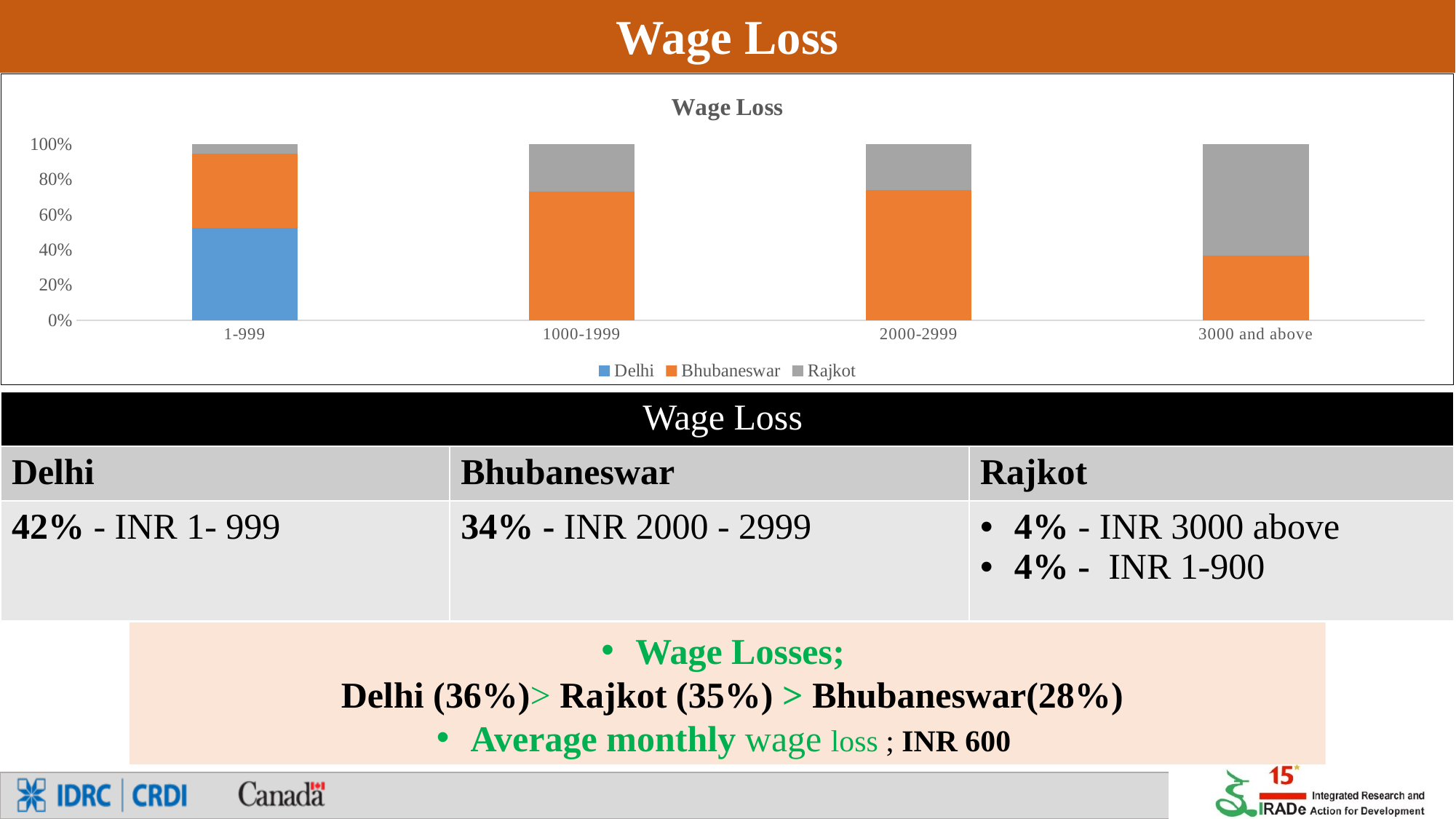
Which colour represents Rajkot in the chart? Grey Is the Bhubaneswar share in the 1000-1999 bar greater or less than 60%? greater In which category does Delhi appear in the stacked bars? 1-999 In which category is the Rajkot share the largest? 3000 and above Is the Rajkot share in the 3000 and above bar greater or less than 50%? greater What is the title of the chart? Wage Loss What kind of chart is shown on the slide? Stacked bar chart In the 3000 and above bar, which is larger, the Rajkot share or the Bhubaneswar share? Rajkot How many wage-loss categories are shown on the x axis of the chart? 4 Is the Rajkot share in the 1000-1999 bar greater or less than 40%? less How many series does the chart legend list? 3